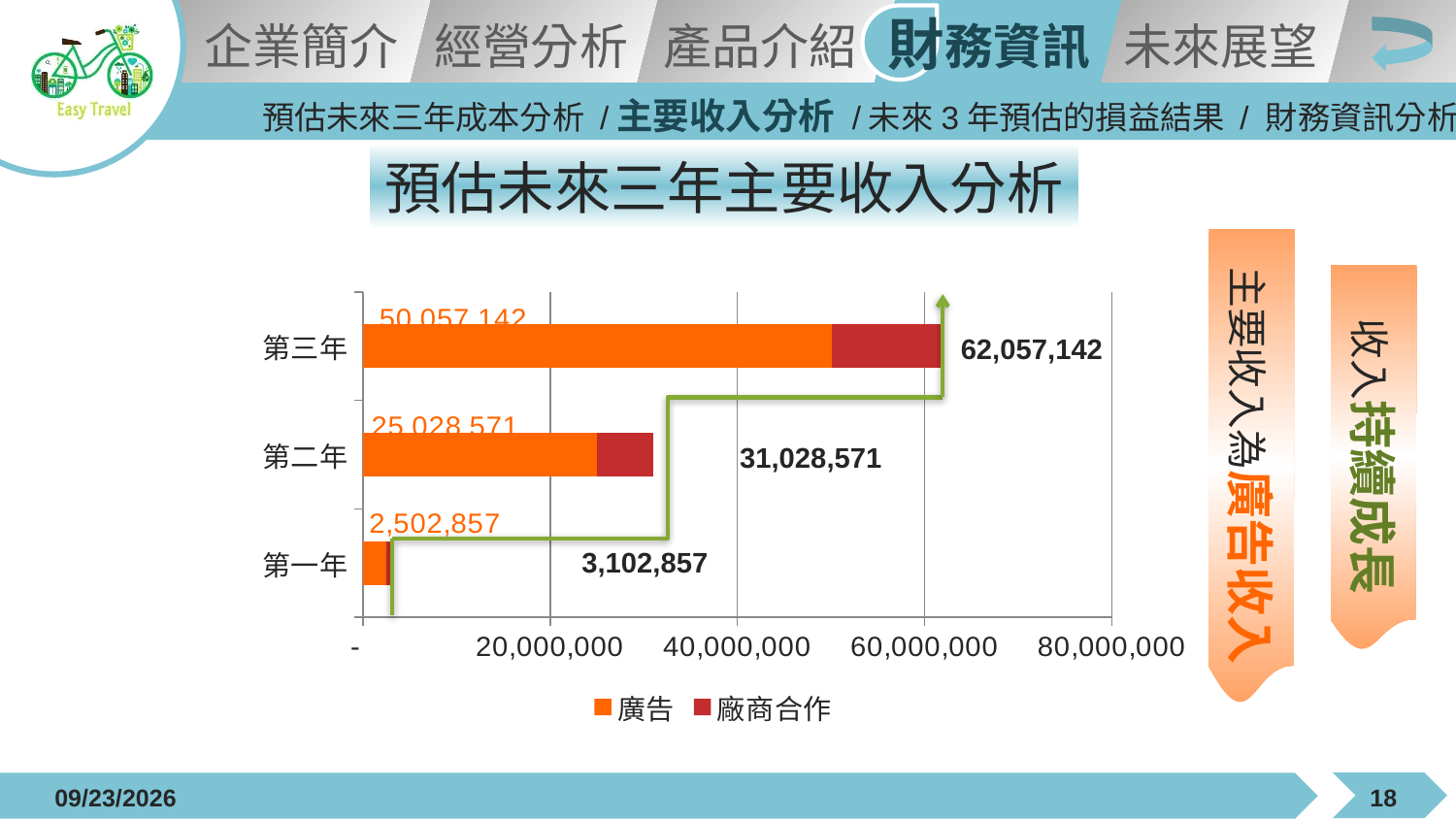
Which year has the highest total revenue? 第三年 Is the total for 第二年 greater or less than 40,000,000? less What is the value of 廣告 for 第三年? 50,057,142 What is the difference between the 廣告 value for 第三年 and the 廣告 value for 第二年? 25,028,571 Which year has the lowest 廣告 value? 第一年 Which is larger, the total for 第二年 or the total for 第一年? 第二年 How many series does the legend list? 2 What is the value of 廣告 for 第一年? 2,502,857 Do the total values rise or fall from 第一年 to 第三年? rise What is the total of the stacked bar for 第三年? 62,057,142 How many categories (years) are shown on the chart? 3 What is the total of the stacked bar for 第二年? 31,028,571